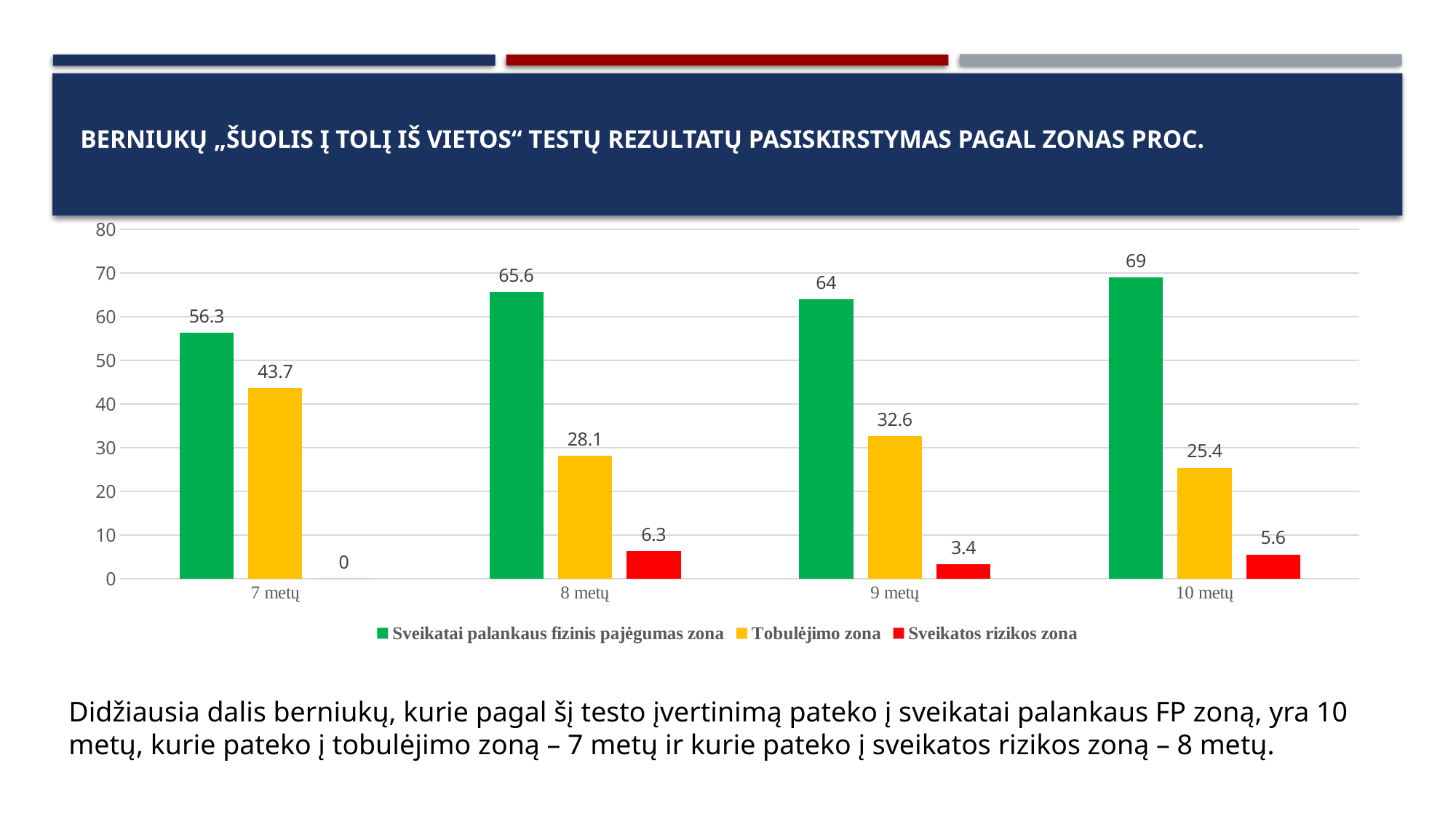
Which is larger: the 'Sveikatos rizikos zona' value for 8 metų or for 10 metų? 8 metų What is the value for 'Tobulėjimo zona' for 7 metų? 43.7 How many series does the legend list? 3 What is the difference between the 'Tobulėjimo zona' values for 7 metų and 10 metų? 18.3 Is the value for 'Sveikatai palankaus fizinis pajėgumas zona' for 9 metų greater or less than 60? greater What colour represents 'Sveikatos rizikos zona' in the chart? Red What is the value for 'Sveikatai palankaus fizinis pajėgumas zona' for 8 metų? 65.6 Which age group has the highest value for 'Sveikatai palankaus fizinis pajėgumas zona'? 10 metų What kind of chart is shown on the slide? Bar chart How many age groups are shown on the x axis? 4 What is the value for 'Sveikatos rizikos zona' for 9 metų? 3.4 Which age group has the lowest value for 'Sveikatos rizikos zona'? 7 metų